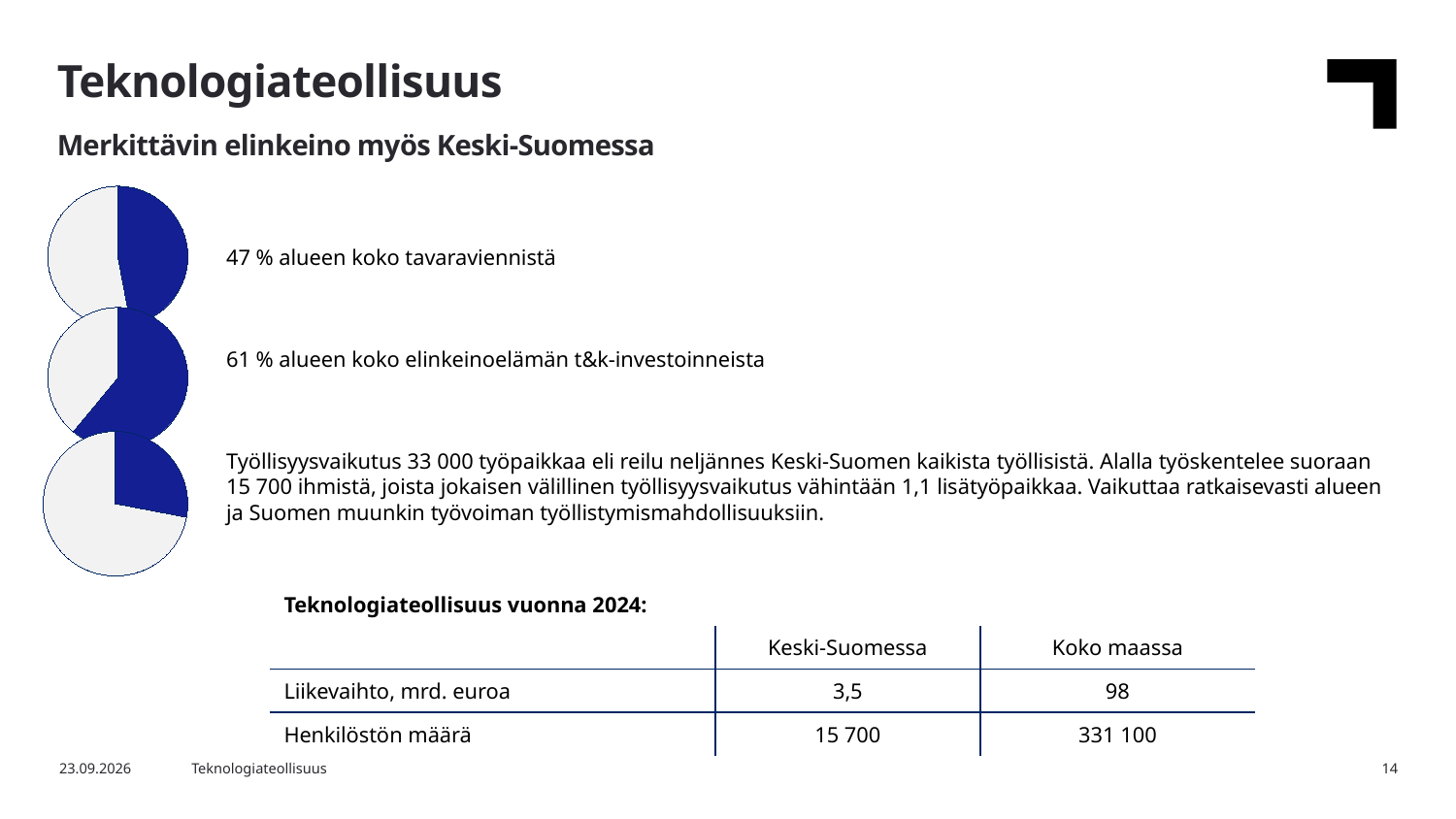
What is the difference in percentage points between the blue share in the middle pie chart (61 %) and the top pie chart (47 %)? 14 percentage points In the middle pie chart, what share of the region's business R&D investments does the blue slice represent, according to the text next to it? 61 % In the middle pie chart, is the blue slice greater or less than 50 % of the pie? greater In the top pie chart, what share of the region's total goods exports does the blue slice represent, according to the text next to it? 47 % How many slices does each pie chart have? 2 In the bottom pie chart, is the blue slice greater or less than 50 % of the pie? less What kind of charts are shown on the left side of the slide? Pie charts Which pie chart has the smallest blue slice? The bottom one What colour is the highlighted slice in each pie chart? Blue Which pie chart has the larger blue slice, the top one or the middle one? The middle one How many pie charts are on the slide? 3